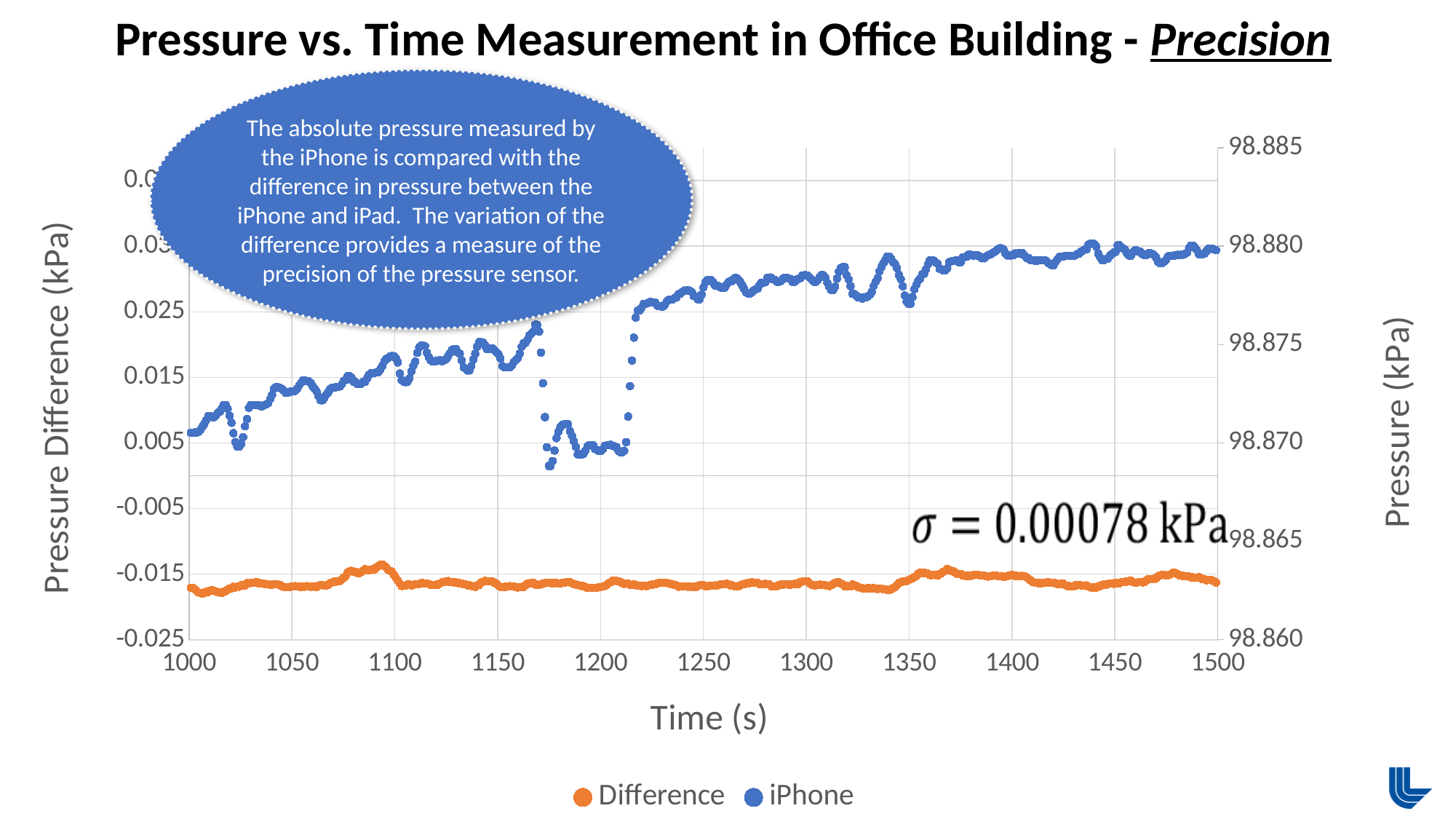
Does the iPhone series overall rise or fall from 1000 s to 1500 s? rise At 1300 s, which series appears higher on the chart, Difference or iPhone? iPhone Is the iPhone value at 1250 s greater or less than 98.875 on the right axis? greater Is the iPhone value at 1500 s greater or less than 98.875 on the right axis? greater Is the Difference value at 1200 s greater or less than -0.005 on the left axis? less What kind of chart is shown on the slide? scatter chart What are the two series named in the legend? Difference and iPhone Which series is plotted in orange? Difference How many series does the legend list? 2 What value of σ is printed on the chart? 0.00078 kPa